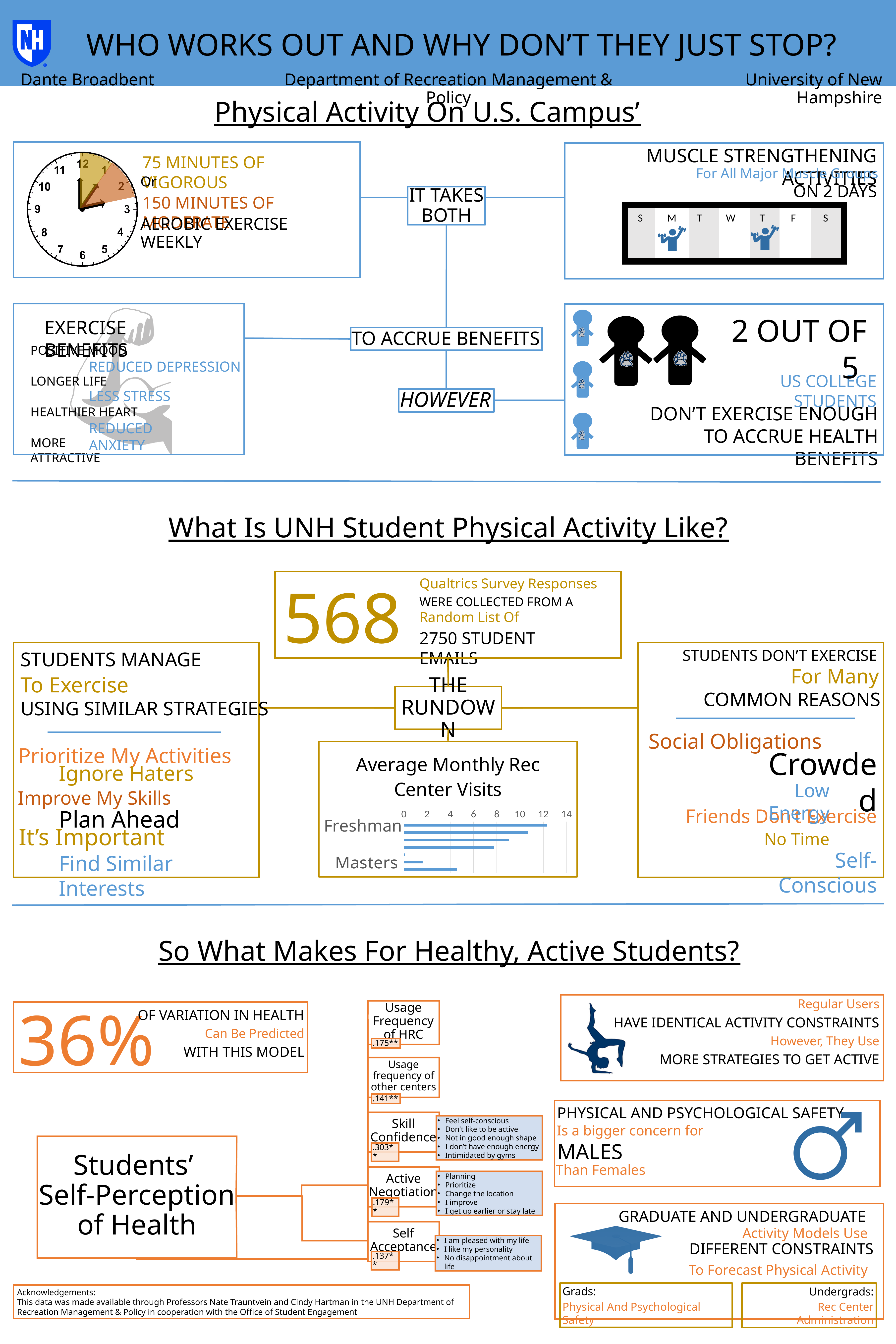
In the "Average Monthly Rec Center Visits" chart, is the value for Freshman greater or less than 10? greater In the "Average Monthly Rec Center Visits" chart, is the value for Freshman greater or less than 14? less In the "Average Monthly Rec Center Visits" chart, which labeled category has the highest value? Freshman In the "Average Monthly Rec Center Visits" chart, which labeled category has the lowest value? Masters What is the highest tick value shown on the axis of the "Average Monthly Rec Center Visits" chart? 14 In the "Average Monthly Rec Center Visits" chart, is the value for Masters greater or less than 4? less How many bars are plotted in the "Average Monthly Rec Center Visits" chart? 7 In the "Average Monthly Rec Center Visits" chart, which has more visits, Freshman or Masters? Freshman What kind of chart is the "Average Monthly Rec Center Visits" chart? bar chart What is the title of the bar chart in the middle section of the slide? Average Monthly Rec Center Visits